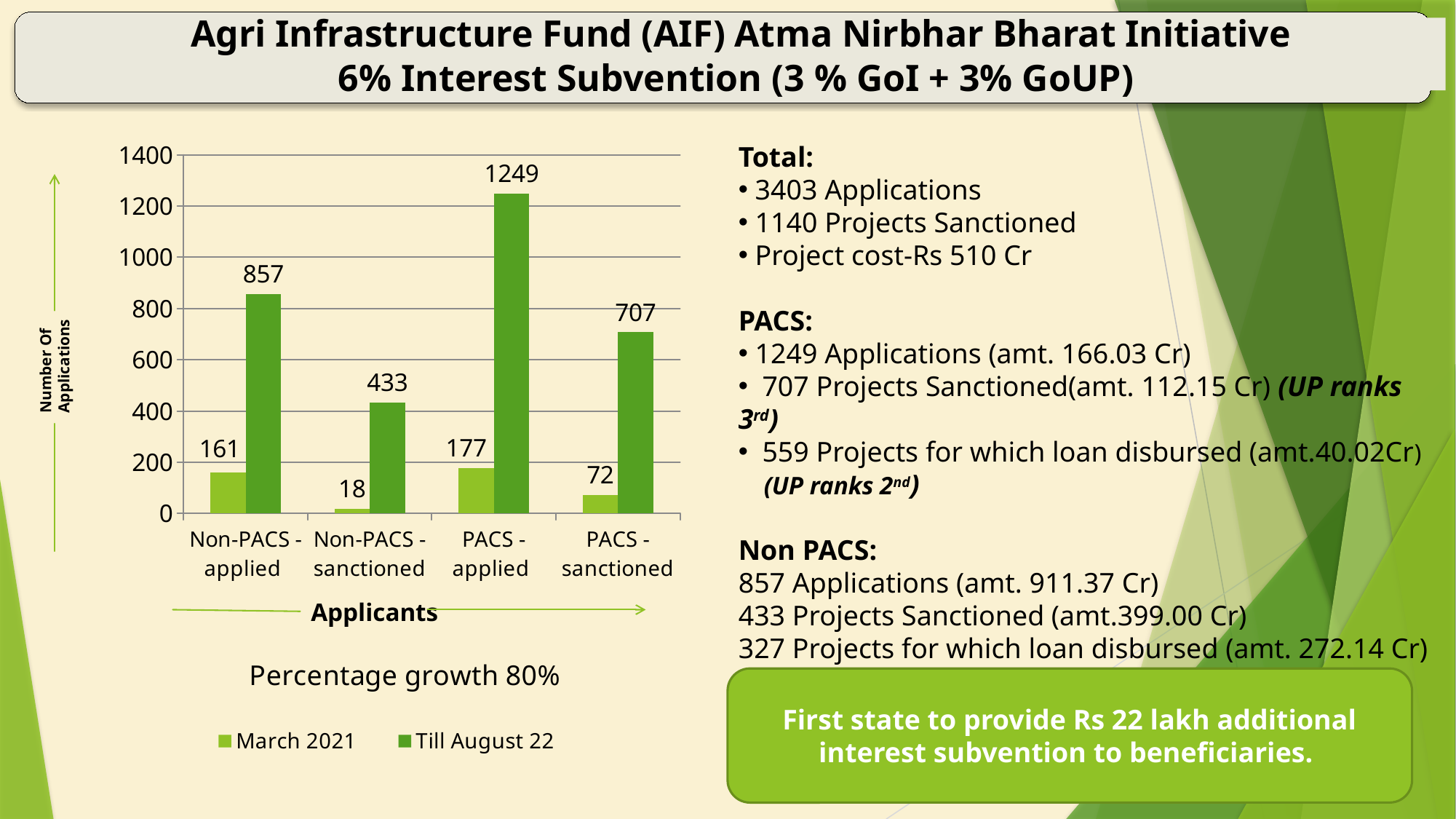
What is the value for Non-PACS - sanctioned in the March 2021 series? 18 What is the value for PACS - applied in the Till August 22 series? 1249 What is the label of the y axis of the chart? Number Of Applications What kind of chart is shown on the slide? Bar chart Which is larger: the Till August 22 value for Non-PACS - sanctioned or for PACS - sanctioned? PACS - sanctioned How many categories are shown on the x axis of the chart? 4 How many series does the chart legend list? 2 What are the two series listed in the chart legend? March 2021 and Till August 22 What is the value for PACS - sanctioned in the Till August 22 series? 707 What is the difference between the Till August 22 and March 2021 values for Non-PACS - applied? 696 Which category has the lowest value in the March 2021 series? Non-PACS - sanctioned Which category has the highest value in the Till August 22 series? PACS - applied